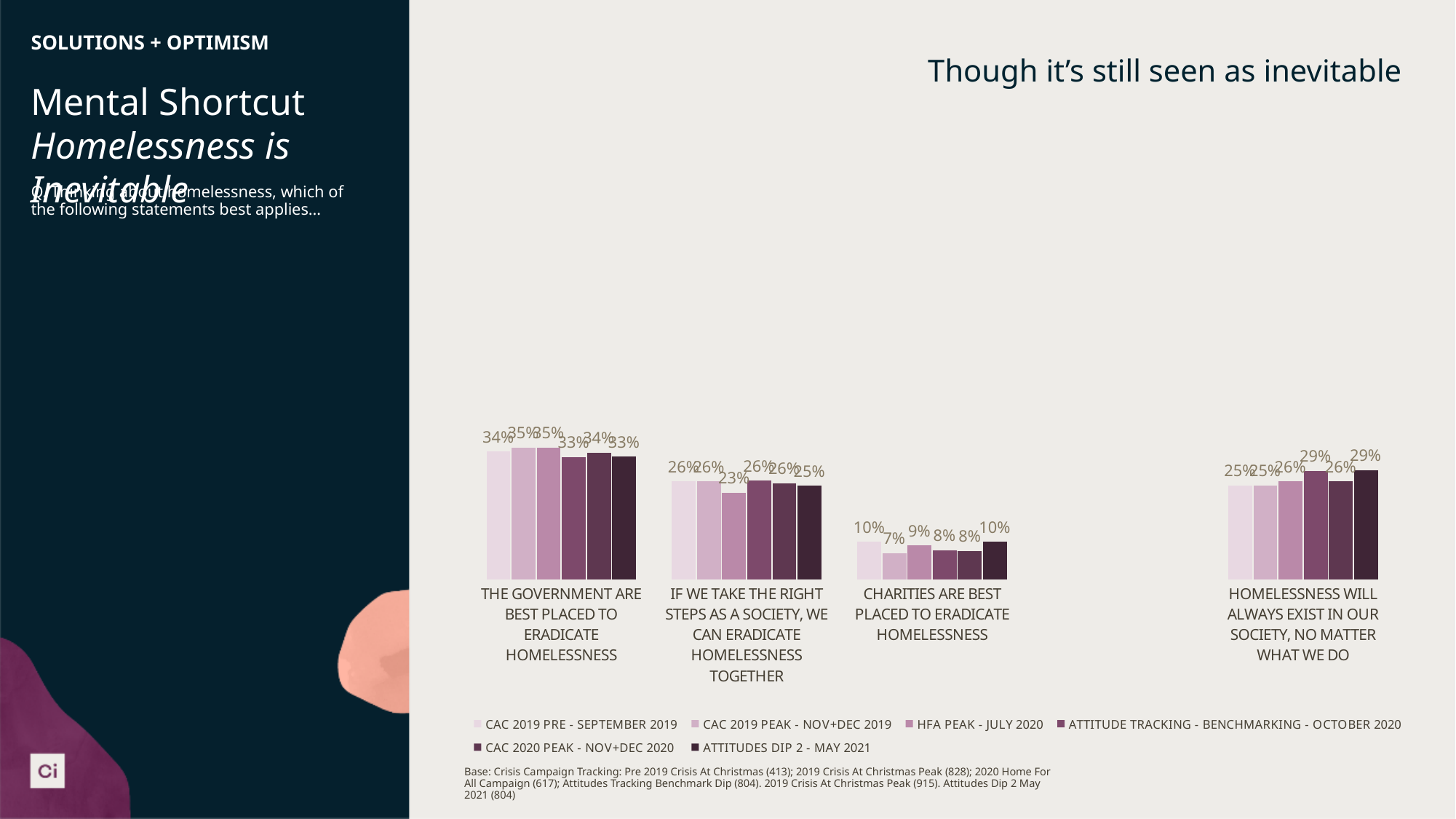
What kind of chart is shown on the slide? bar chart For the Attitudes Dip 2 - May 2021 series, which is larger: the value for 'The government are best placed to eradicate homelessness' or the value for 'Homelessness will always exist in our society, no matter what we do'? The government are best placed to eradicate homelessness What is the difference between the CAC 2019 Pre - September 2019 value and the CAC 2019 Peak - Nov+Dec 2019 value for 'Charities are best placed to eradicate homelessness'? 3% What is the value for 'Charities are best placed to eradicate homelessness' in the CAC 2019 Peak - Nov+Dec 2019 series? 7% What is the difference between the Attitudes Dip 2 - May 2021 value and the CAC 2019 Pre - September 2019 value for 'Homelessness will always exist in our society, no matter what we do'? 4% How many statement categories are shown on the x axis? 4 What is the value for 'Homelessness will always exist in our society, no matter what we do' in the Attitudes Dip 2 - May 2021 series? 29% What is the heading text shown above the chart? Though it's still seen as inevitable How many series does the legend list? 6 Which statement category has the highest values across all series? The government are best placed to eradicate homelessness What is the value for 'If we take the right steps as a society, we can eradicate homelessness together' in the HFA Peak - July 2020 series? 23% Which statement category has the lowest values across all series? Charities are best placed to eradicate homelessness